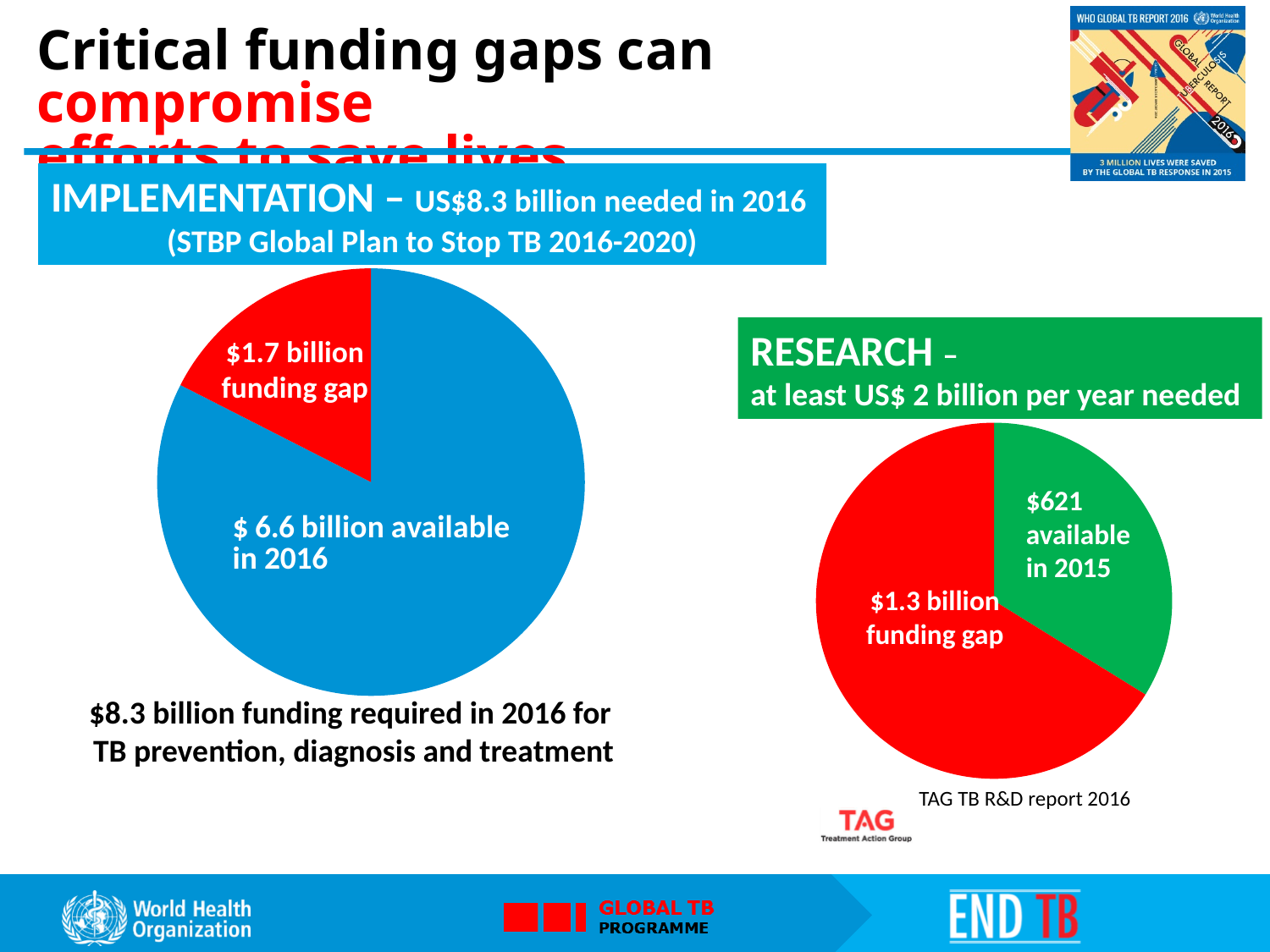
In the right pie chart (Research), what is the value of the funding gap slice? $1.3 billion In the left pie chart (Implementation), how much funding is shown as available in 2016? $6.6 billion In the right pie chart (Research), which slice is the largest? $1.3 billion funding gap In the left pie chart (Implementation), which slice is larger: the funding gap or the amount available in 2016? $6.6 billion available in 2016 In the left pie chart (Implementation), what is the difference between the amount available in 2016 and the funding gap? $4.9 billion In the right pie chart (Research), what amount is shown as available in 2015? $621 What kind of chart is used on the left side of the slide for Implementation funding? Pie chart According to the text below the left pie chart, what is the total funding required in 2016 for TB prevention, diagnosis and treatment? $8.3 billion In the right pie chart (Research), what colour is the funding gap slice? Red In the left pie chart (Implementation), what is the value of the funding gap slice? $1.7 billion In the right pie chart (Research), which slice is the smallest? $621 available in 2015 How many slices does the left pie chart (Implementation) have? 2